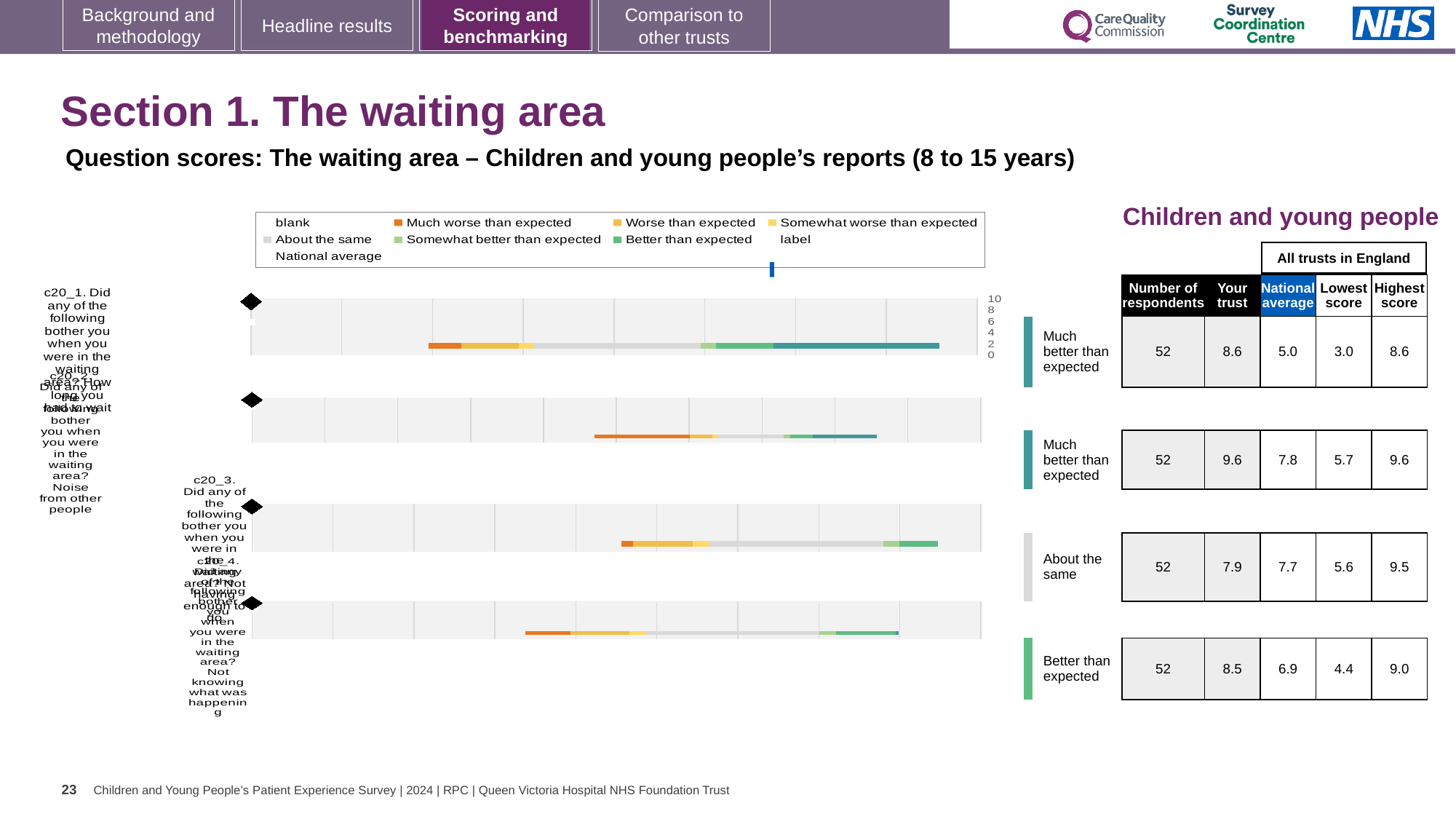
What is the highest value shown on the chart's numeric axis? 10 In the chart legend, which colour represents 'Much worse than expected'? orange In the table beside the chart, how many respondents are listed for the 'About the same' row? 52 What kind of chart is shown on the slide? bar chart In the table beside the chart, which row has the lowest 'Your trust' score? the third row, About the same (7.9) In the table beside the chart, what is the 'Your trust' score for the 'Better than expected' row? 8.5 In the table beside the chart, which row has the highest 'Your trust' score? the second row (9.6) In the table beside the chart, what is the national average for the 'Better than expected' row? 6.9 In the table beside the chart, what is the difference between the 'Your trust' score and the national average for the 'Better than expected' row? 1.6 How many horizontal bars (questions) are plotted in the chart? 4 In the table beside the chart, what is the 'Your trust' score for the 'About the same' row? 7.9 In the table beside the chart, is the 'Your trust' score for the 'About the same' row larger or smaller than its national average? larger